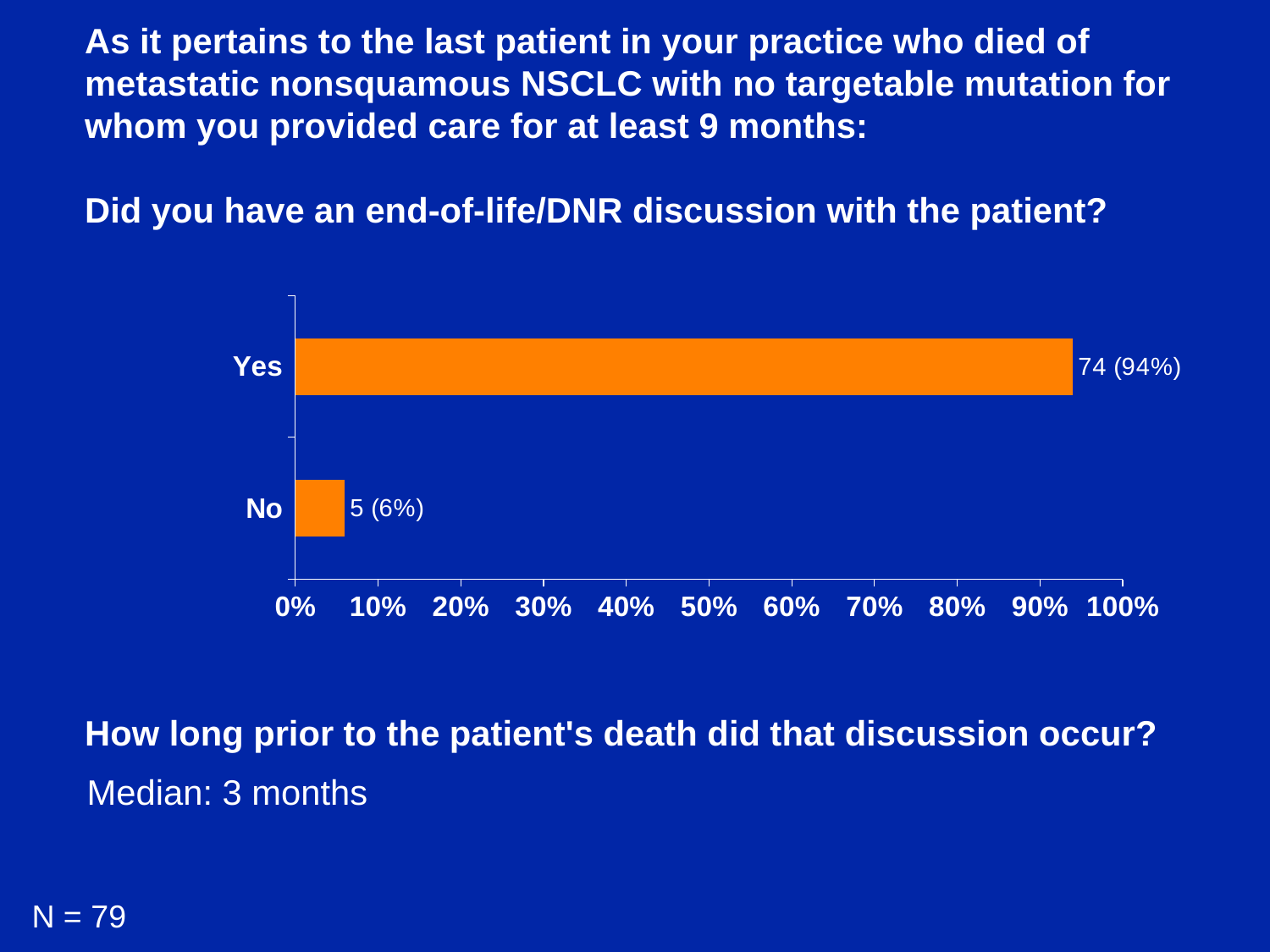
Which category has the highest value? Yes Which category has the lowest value? No Is the value for "No" greater or less than 10%? less What is the maximum value shown on the x axis of the chart? 100% Is the value for "Yes" greater or less than 90%? greater How many categories are shown in the chart? 2 What kind of chart is shown on the slide? bar chart Which is larger, the value for "Yes" or the value for "No"? Yes What is the data label shown for the "Yes" bar? 74 (94%) What is the data label shown for the "No" bar? 5 (6%) What is the difference in percentage points between the "Yes" and "No" bars? 88 How many more respondents answered "Yes" than "No"? 69